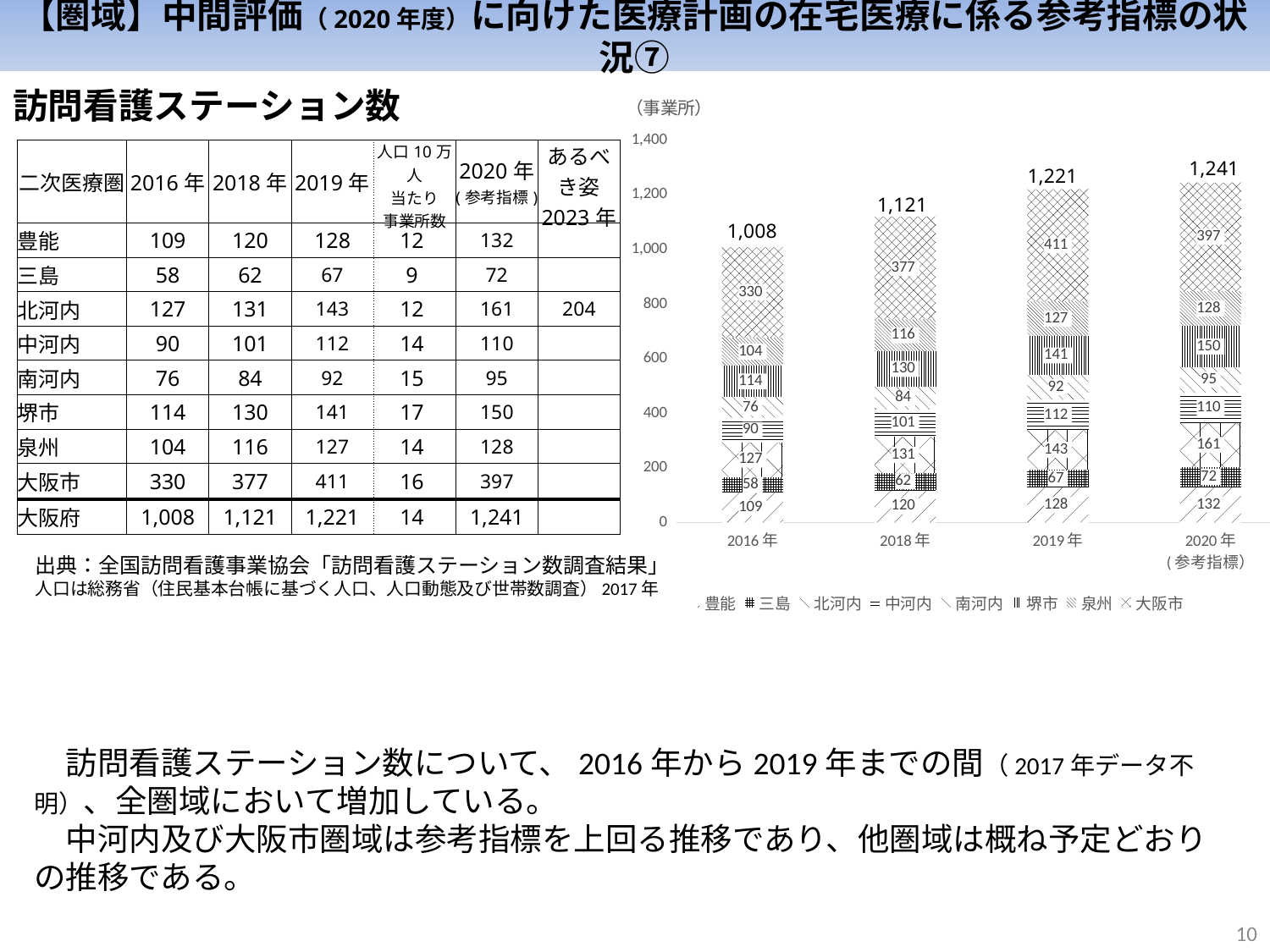
What is the value for 大阪市 in the 2018年 bar? 377 How many series does the chart legend list? 8 Is the value for 大阪市 larger in 2019年 or in 2020年(参考指標)? 2019年 Which year has the lowest stacked bar total? 2016年 Which year has the highest stacked bar total? 2020年(参考指標) Do the stacked bar totals rise or fall from 2016年 to 2020年(参考指標)? rise How many bars (years) are plotted in the chart? 4 What kind of chart is shown on the slide? stacked bar chart What is the total of the stacked bar for 2019年? 1,221 What is the value for 三島 in the 2016年 bar? 58 What is the value for 堺市 in the 2020年(参考指標) bar? 150 What is the difference between the stacked bar totals for 2018年 and 2016年? 113